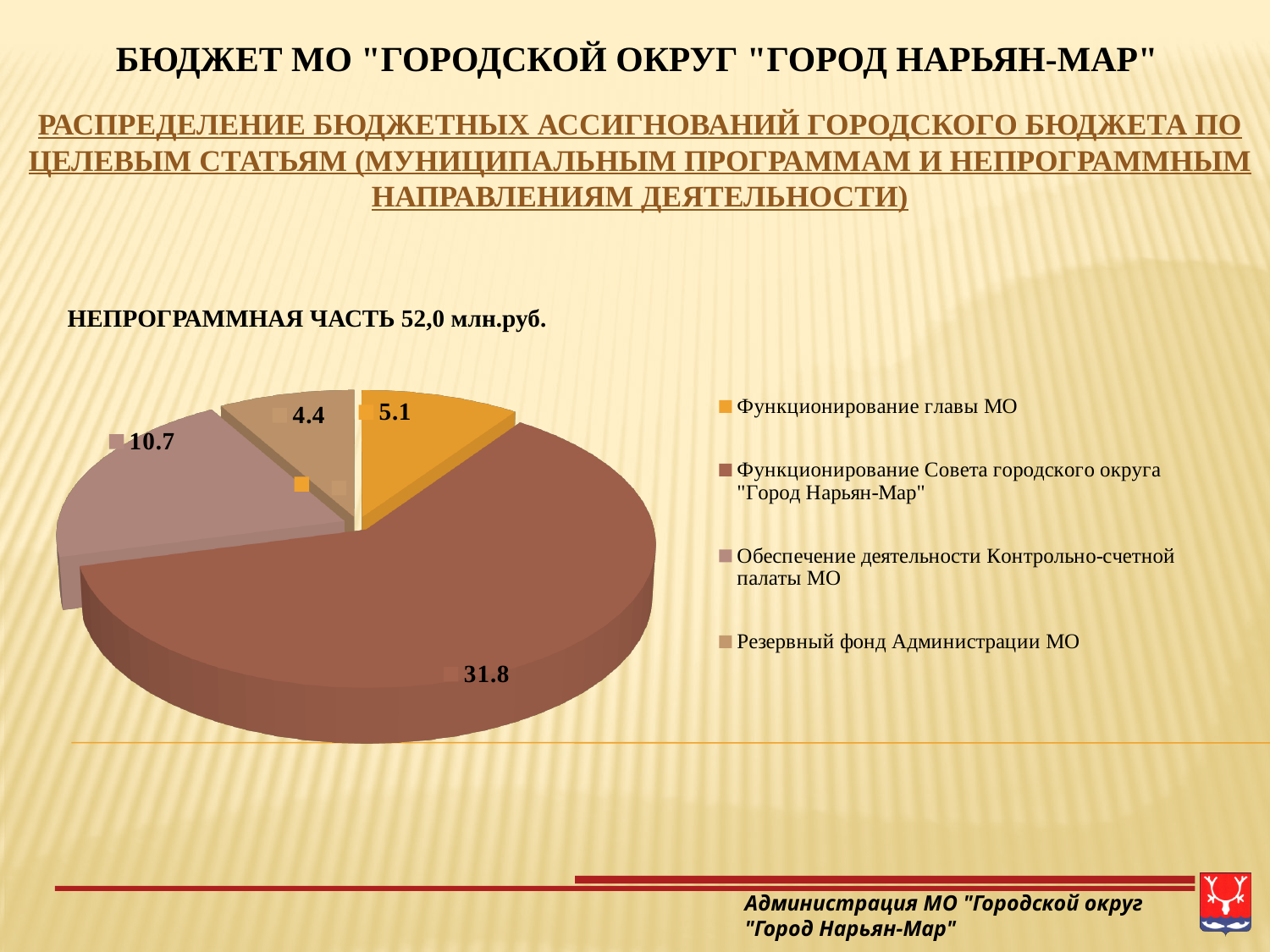
What is the value for "Функционирование Совета городского округа "Город Нарьян-Мар""? 31.8 What is the difference between the values for "Функционирование главы МО" and "Резервный фонд Администрации МО"? 0.7 What is the difference between the values for "Функционирование Совета городского округа "Город Нарьян-Мар"" and "Обеспечение деятельности Контрольно-счетной палаты МО"? 21.1 Which category has the largest slice of the pie? Функционирование Совета городского округа "Город Нарьян-Мар" What is the value for "Функционирование главы МО"? 5.1 What is the value for "Обеспечение деятельности Контрольно-счетной палаты МО"? 10.7 What is the value for "Резервный фонд Администрации МО"? 4.4 How many categories does the pie chart have? 4 Which category has the smallest slice of the pie? Резервный фонд Администрации МО What total amount for the non-programme part is stated above the chart? 52,0 млн.руб. Which is larger: the value for "Обеспечение деятельности Контрольно-счетной палаты МО" or the value for "Функционирование главы МО"? Обеспечение деятельности Контрольно-счетной палаты МО What kind of chart is shown on the slide? Pie chart